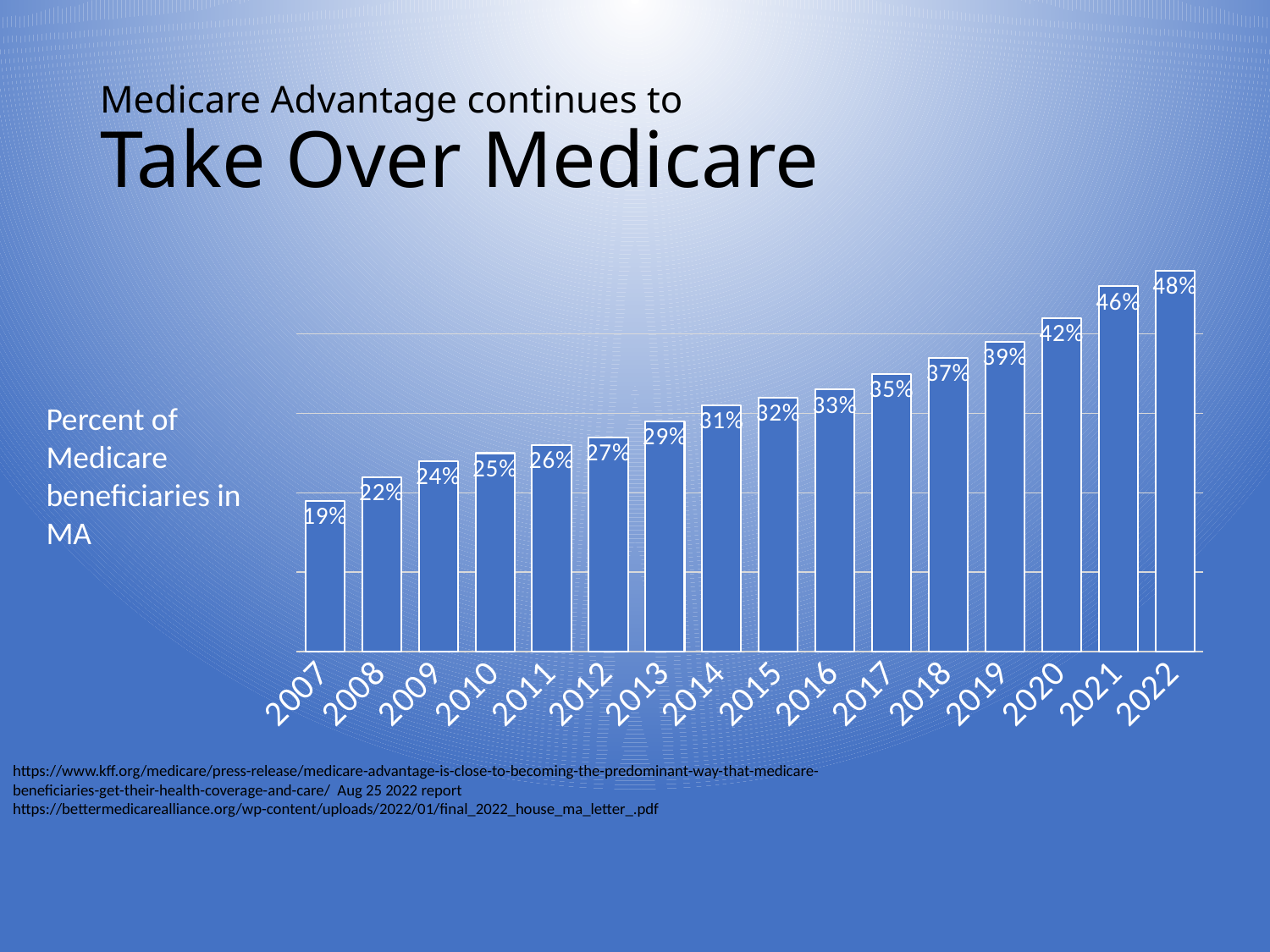
Do the values rise or fall from 2007 to 2022? rise What is the difference between the values for 2021 and 2020? 4% What is the value for 2020? 42% What does the chart show, according to the label to its left? Percent of Medicare beneficiaries in MA What kind of chart is shown? bar chart Which is larger, the value for 2012 or the value for 2018? 2018 Which year has the lowest value? 2007 What is the value for 2007? 19% Which year has the highest value? 2022 What is the difference between the values for 2022 and 2007? 29% How many years are shown on the x axis? 16 What is the value for 2015? 32%